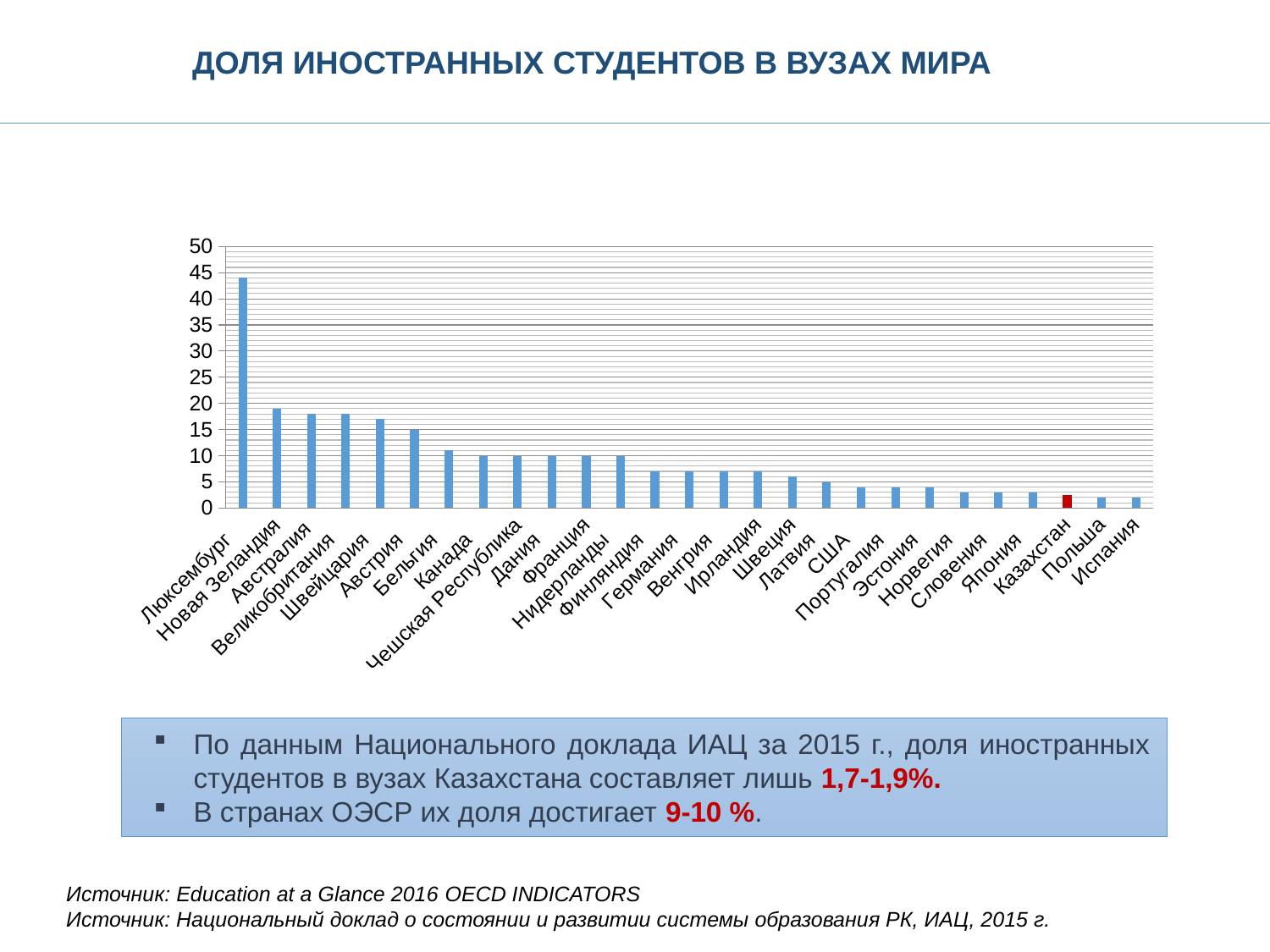
Is the value for Германия greater or less than 5? greater Which has a larger value, Люксембург or Новая Зеландия? Люксембург Is the value for Новая Зеландия greater or less than 15? greater Which country has the highest share of foreign students in the chart? Люксембург Is the value for Казахстан greater or less than 5? less What kind of chart is shown on the slide? bar chart How many countries are shown on the x axis of the chart? 27 Which country's bar is coloured red instead of blue? Казахстан Do the values rise or fall moving from left to right along the x axis? fall Which has a larger value, Бельгия or Казахстан? Бельгия